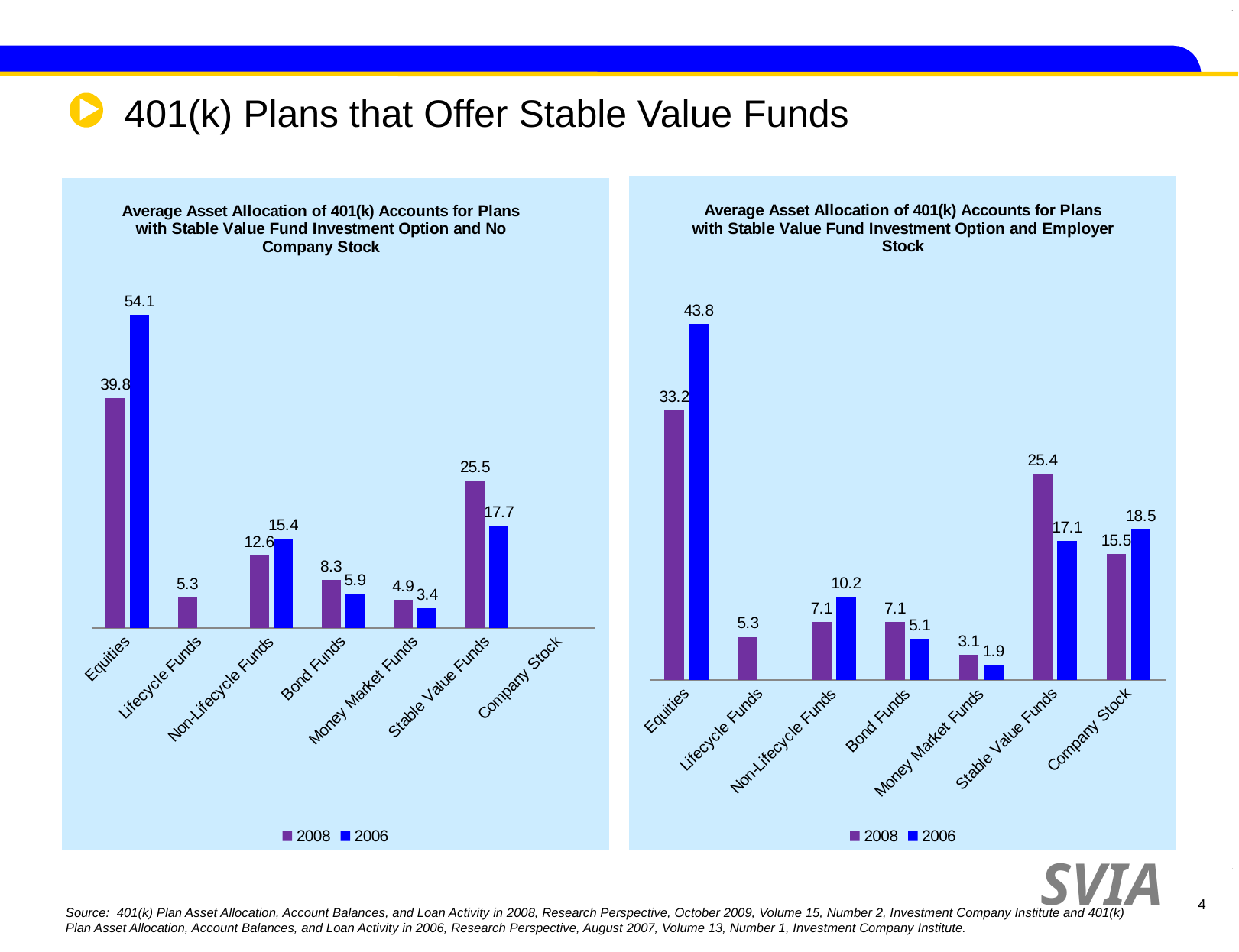
In the left chart (No Company Stock), what is the difference between the 2006 and 2008 values for Equities? 14.3 In the right chart (Employer Stock), is the 2008 value for Bond Funds larger or smaller than the 2006 value for Bond Funds? larger How many series does the legend of the left chart list? 2 In the right chart (Employer Stock), what is the 2006 value for Non-Lifecycle Funds? 10.2 How many categories are shown on the x axis of the right chart (Employer Stock)? 7 In the right chart (Employer Stock), what is the 2008 value for Company Stock? 15.5 In the left chart (No Company Stock), what is the 2008 value for Stable Value Funds? 25.5 In the right chart (Employer Stock), what is the difference between the 2008 and 2006 values for Stable Value Funds? 8.3 In the left chart (No Company Stock), what is the 2006 value for Equities? 54.1 In the right chart (Employer Stock), which category has the lowest 2006 value? Money Market Funds In the left chart (No Company Stock), which category has the highest 2008 value? Equities What type of chart is the right chart (Employer Stock)? bar chart